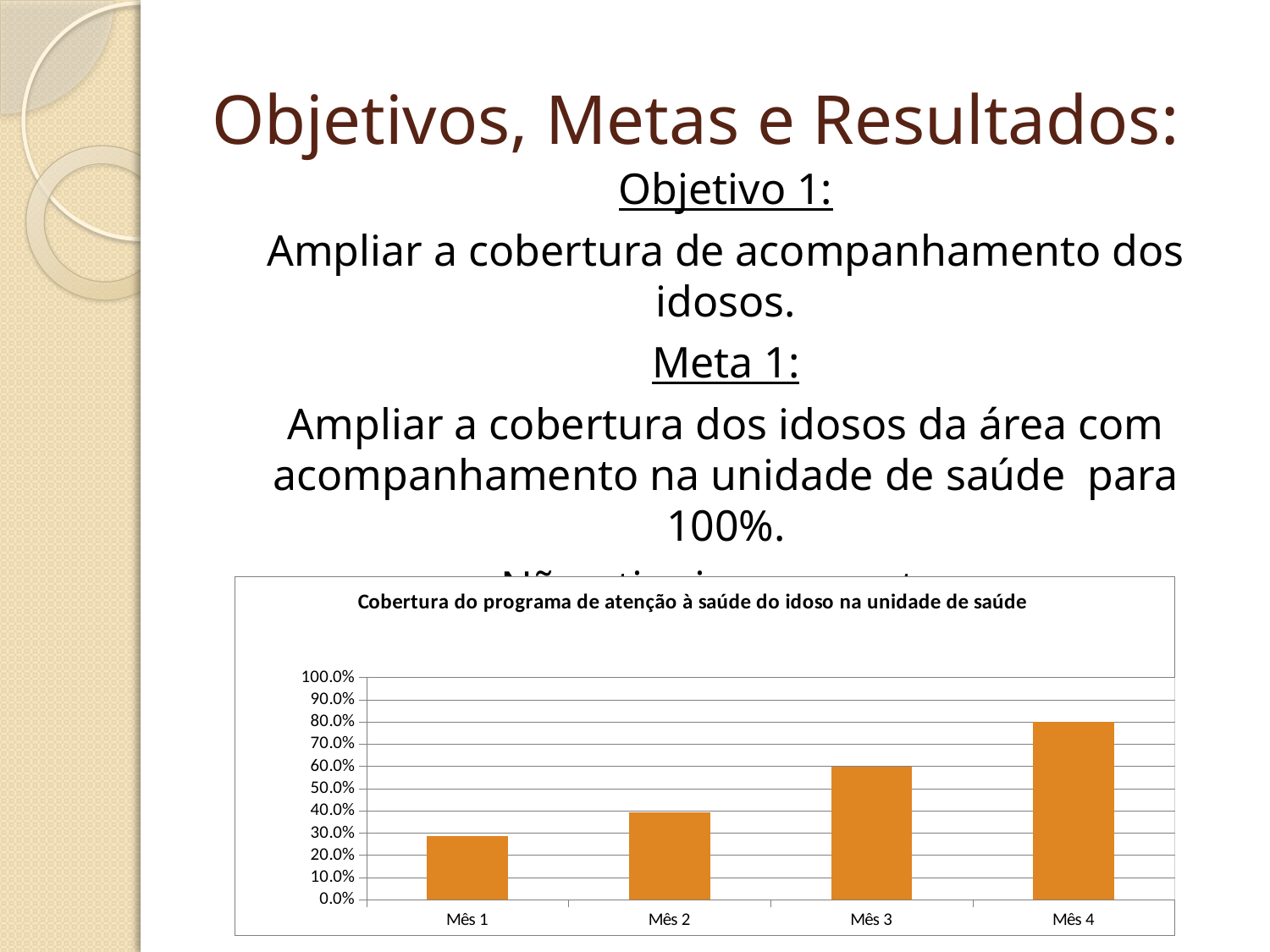
What is the title of the chart? Cobertura do programa de atenção à saúde do idoso na unidade de saúde Which month has the lowest coverage value in the chart? Mês 1 Which month has the highest coverage value in the chart? Mês 4 Do the values rise or fall from Mês 1 to Mês 4? rise How many categories (months) are shown on the x axis of the chart? 4 What type of chart is shown on the slide? bar chart Is the value for Mês 2 greater or less than 30.0%? greater Is the value for Mês 4 greater or less than 70.0%? greater What is the maximum value shown on the y axis of the chart? 100.0% Which is larger, the value for Mês 2 or the value for Mês 3? Mês 3 Is the value for Mês 1 greater or less than 30.0%? less